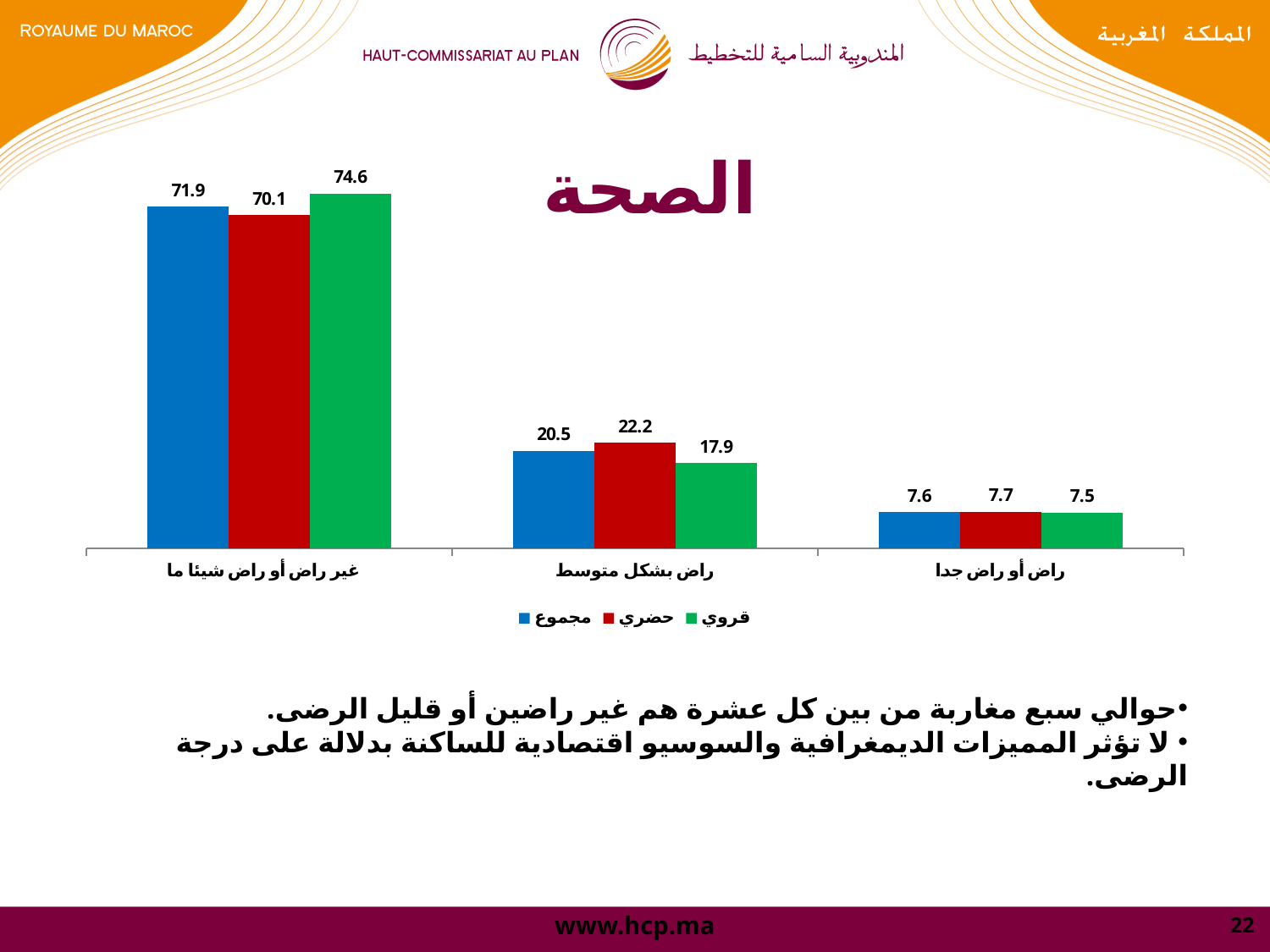
Which category has the highest value for the قروي series? غير راض أو راض شيئا ما In the category راض بشكل متوسط, which is larger: the value for حضري or the value for قروي? حضري What type of chart is shown on the slide? bar chart How many categories are shown on the x axis? 3 What is the title of the chart? الصحة What is the value for مجموع in the category غير راض أو راض شيئا ما? 71.9 Which category has the lowest value for the مجموع series? راض أو راض جدا How many series does the legend list? 3 What is the value for قروي in the category راض بشكل متوسط? 17.9 Which series is shown in green in the legend? قروي What is the difference between the قروي and حضري values in the category غير راض أو راض شيئا ما? 4.5 What is the value for حضري in the category راض أو راض جدا? 7.7